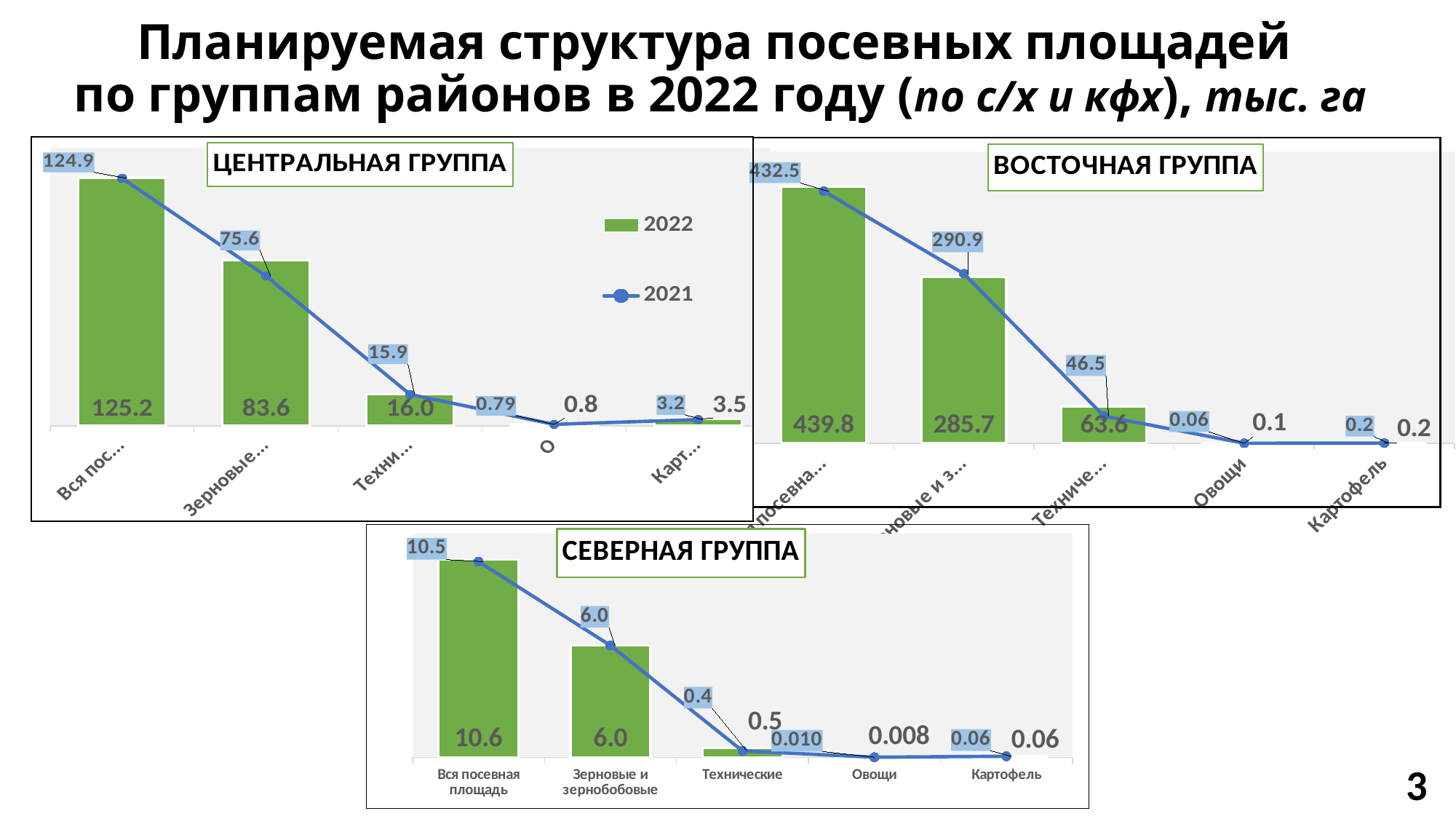
In the Восточная группа chart, what is the 2021 value for Овощи? 0.06 In the Восточная группа chart, which has the larger 2022 value, Овощи or Картофель? Картофель In the Северная группа chart, do the 2022 values rise or fall from Вся посевная площадь to Овощи? fall In the Северная группа chart, what is the difference between the 2022 and 2021 values for Технические? 0.1 In the Северная группа chart, what is the 2021 value for Технические? 0.4 In the Северная группа chart, how many categories are shown on the x axis? 5 In the Северная группа chart, what is the 2022 value for Вся посевная площадь? 10.6 In the Северная группа chart, which category has the highest 2022 value? Вся посевная площадь In the Восточная группа chart, what is the 2022 value for Картофель? 0.2 In the Северная группа chart, what is the 2022 value for Овощи? 0.008 In the Северная группа chart, which category has the lowest 2022 value? Овощи How many series does the legend in the Центральная группа chart list? 2